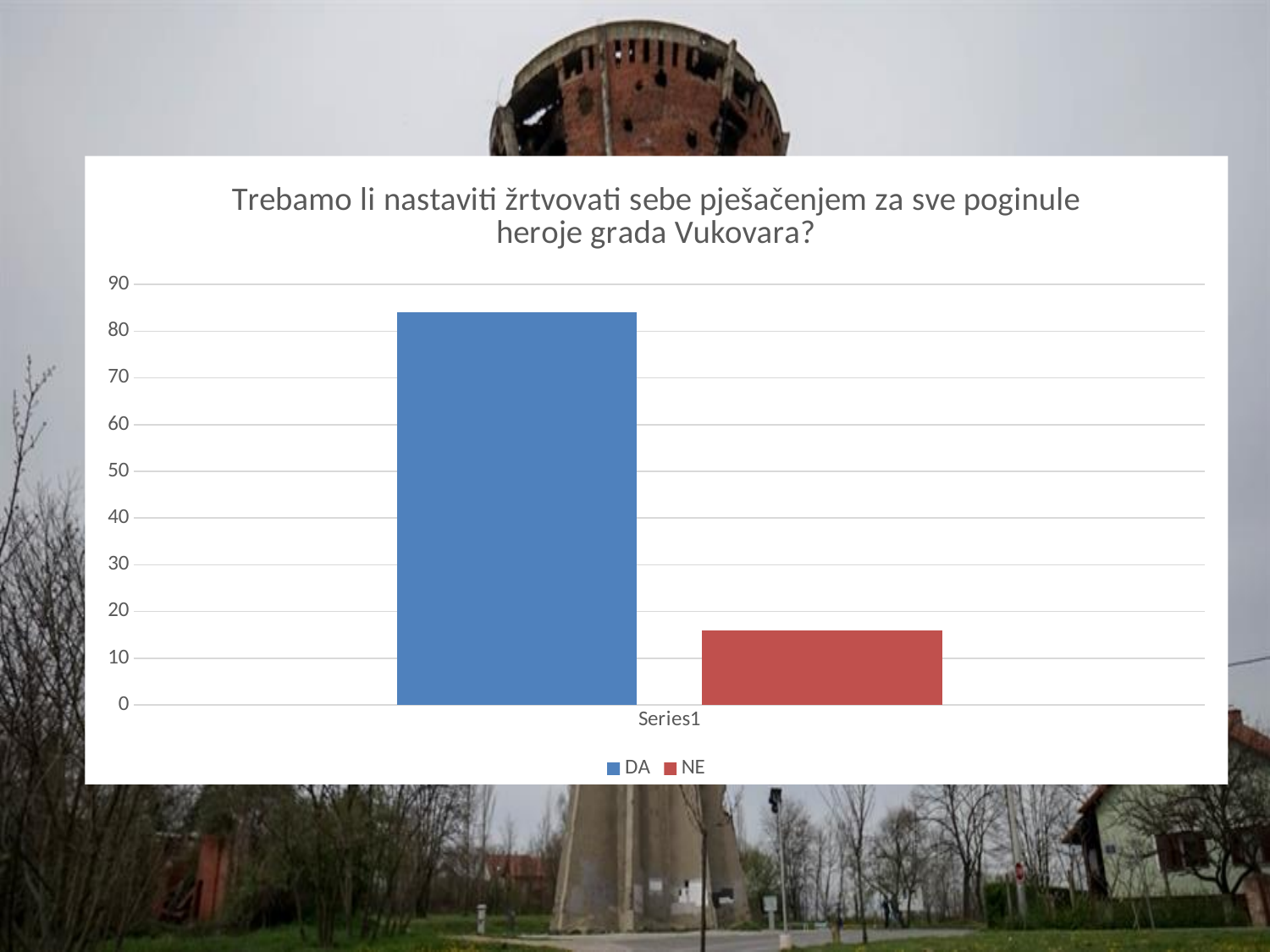
Which is larger, the value for DA or the value for NE? DA Is the value for NE greater or less than 20? less Which series has the lowest bar? NE Which series has the highest bar? DA Is the value for DA greater or less than 80? greater What is the title of the chart? Trebamo li nastaviti žrtvovati sebe pješačenjem za sve poginule heroje grada Vukovara? What kind of chart is shown on the slide? bar chart How many categories are shown on the x axis? 1 Is the value for NE greater or less than 10? greater How many series does the legend list? 2 What colour is the bar for NE? red